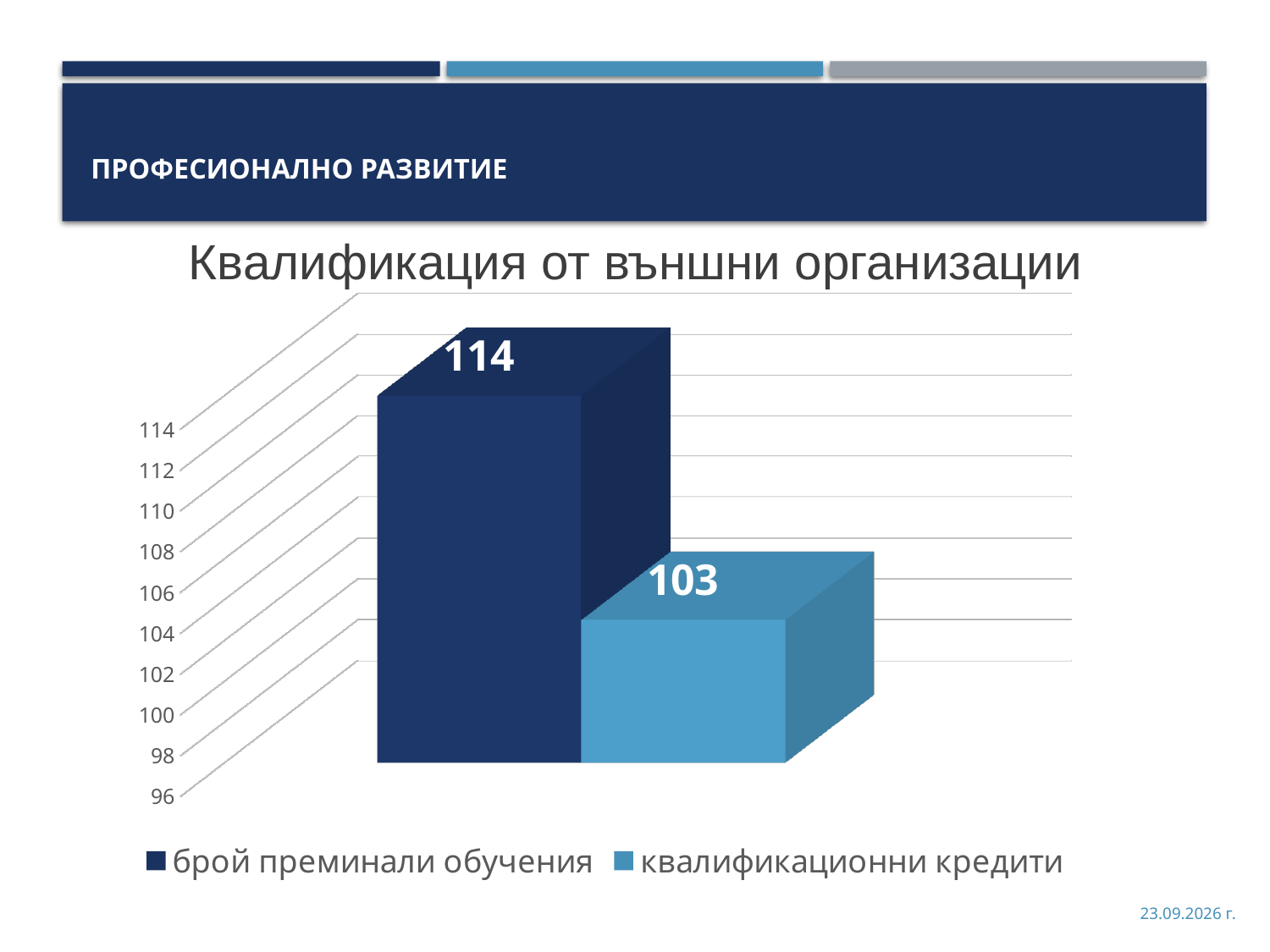
What is the difference between "брой преминали обучения" and "квалификационни кредити"? 11 What is the value for "брой преминали обучения"? 114 Is the value for "квалификационни кредити" greater or less than 110? less What is the title of the chart? Квалификация от външни организации Which is larger, "брой преминали обучения" or "квалификационни кредити"? брой преминали обучения What kind of chart is shown on the slide? bar chart How many bars are plotted on the chart? 2 How many series does the legend list? 2 What is the value for "квалификационни кредити"? 103 Which series has the highest value? брой преминали обучения Is the value for "брой преминали обучения" greater or less than 110? greater Which series has the lowest value? квалификационни кредити